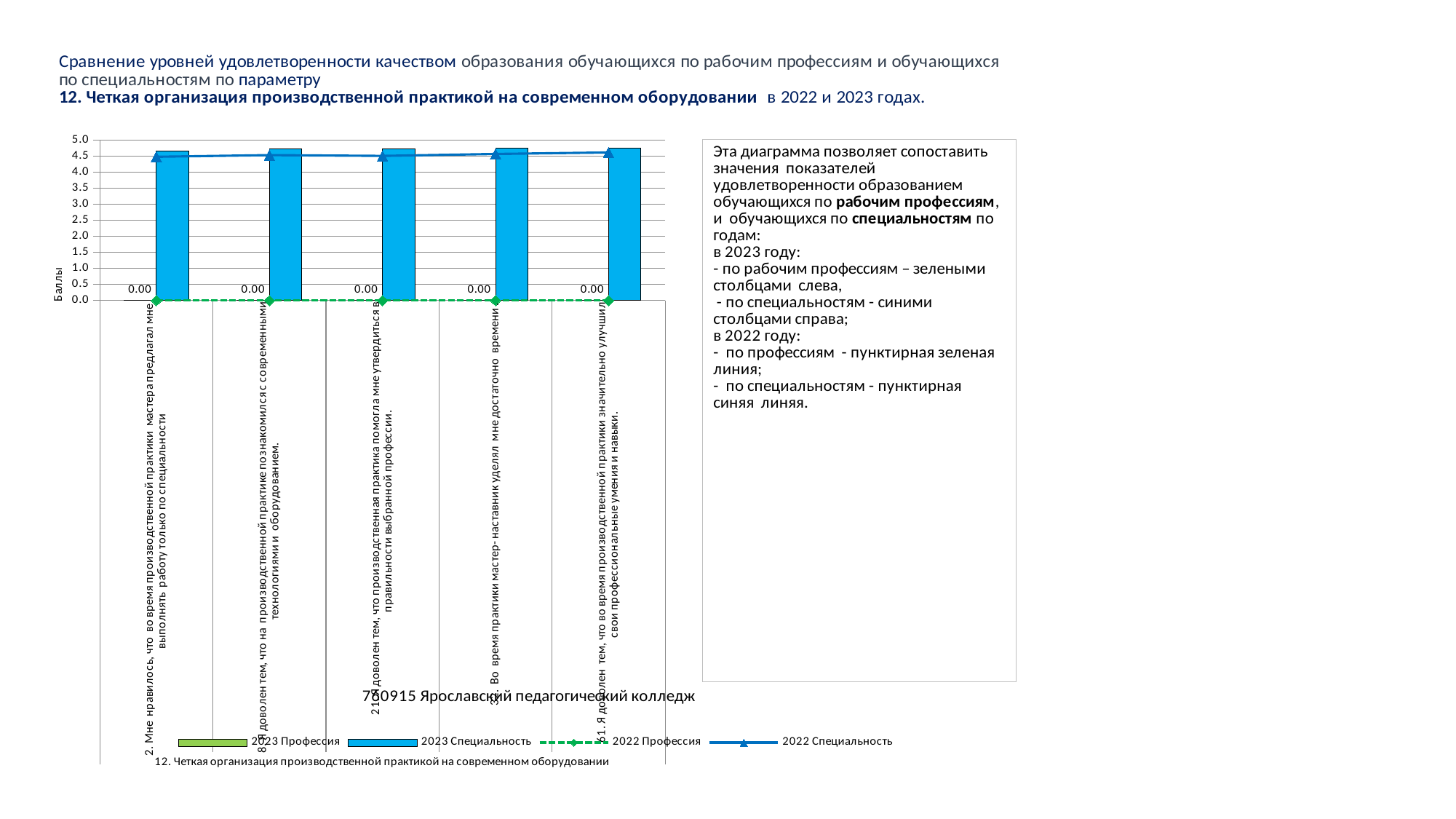
What is the value of the 2023 Профессия series for the first (leftmost) category? 0.00 What is the title shown at the bottom of the chart? 12. Четкая организация производственной практикой на современном оборудовании What is the title of the chart's vertical axis? Баллы Is the value of the 2023 Специальность bar for the third category greater or less than 3.0? greater For the first category, which is larger: the 2023 Специальность value or the 2023 Профессия value? 2023 Специальность How many categories are plotted along the x axis of the chart? 5 What kind of chart is shown on the slide? combination bar and line chart Is the value of the 2022 Специальность line for the first category greater or less than 4.0? greater How many series does the chart legend list? 4 What is the value of the 2023 Профессия series for the last (rightmost) category? 0.00 Which series has the lowest values across all categories in the chart? 2023 Профессия and 2022 Профессия (both 0) Is the value of the 2023 Специальность bar for the first category greater or less than 4.0? greater